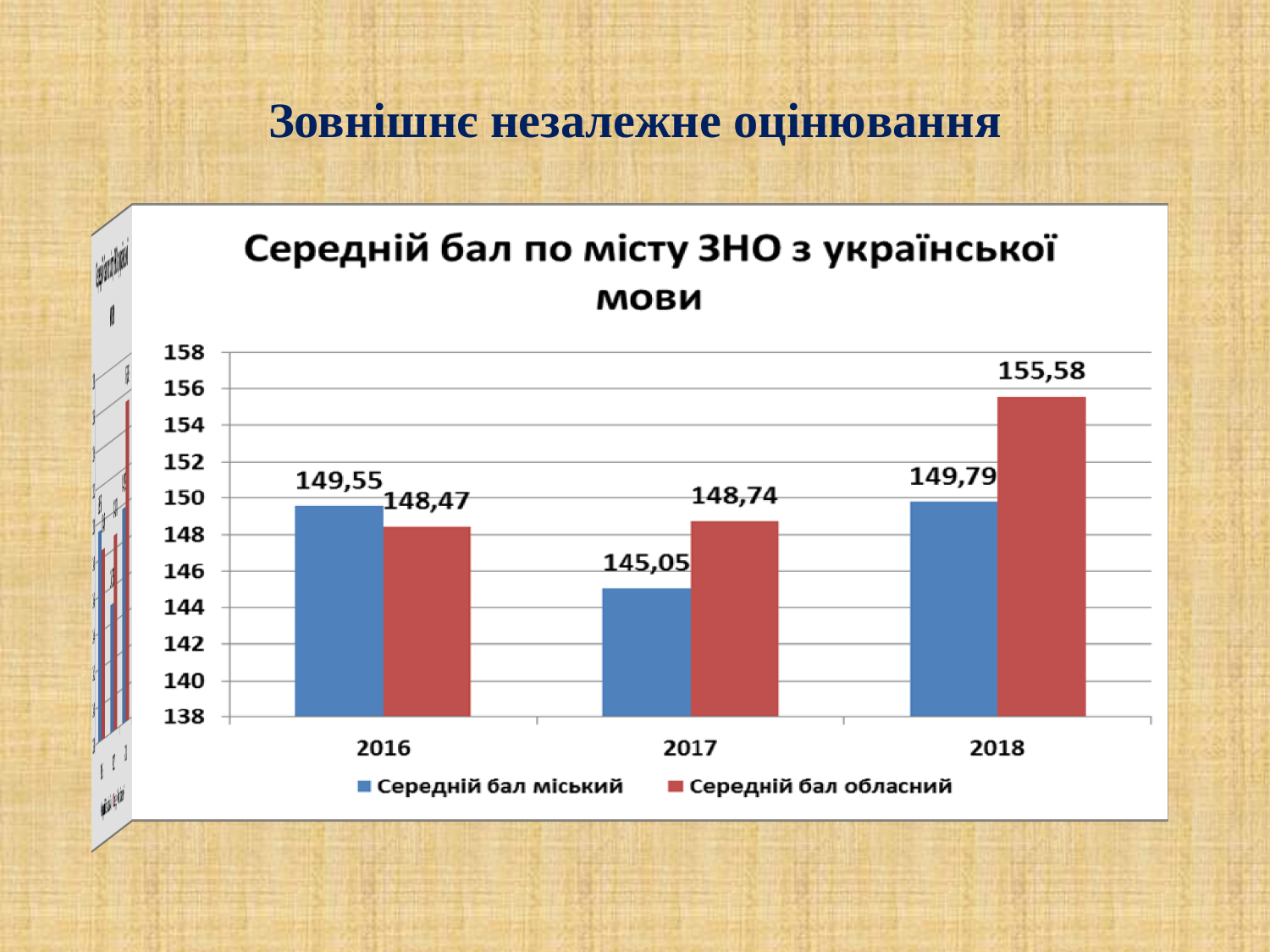
What is the value of Середній бал обласний for 2017? 148,74 What type of chart is shown? Bar chart How many series does the legend list? 2 What is the difference between Середній бал міський and Середній бал обласний in 2016? 1,08 What is the value of Середній бал міський for 2017? 145,05 Which is larger in 2016: Середній бал міський or Середній бал обласний? Середній бал міський What is the difference between Середній бал обласний and Середній бал міський in 2018? 5,79 What is the value of Середній бал міський for 2016? 149,55 In which year is Середній бал обласний the highest? 2018 In which year is Середній бал міський the lowest? 2017 How many years are shown on the x axis? 3 What is the value of Середній бал обласний for 2018? 155,58